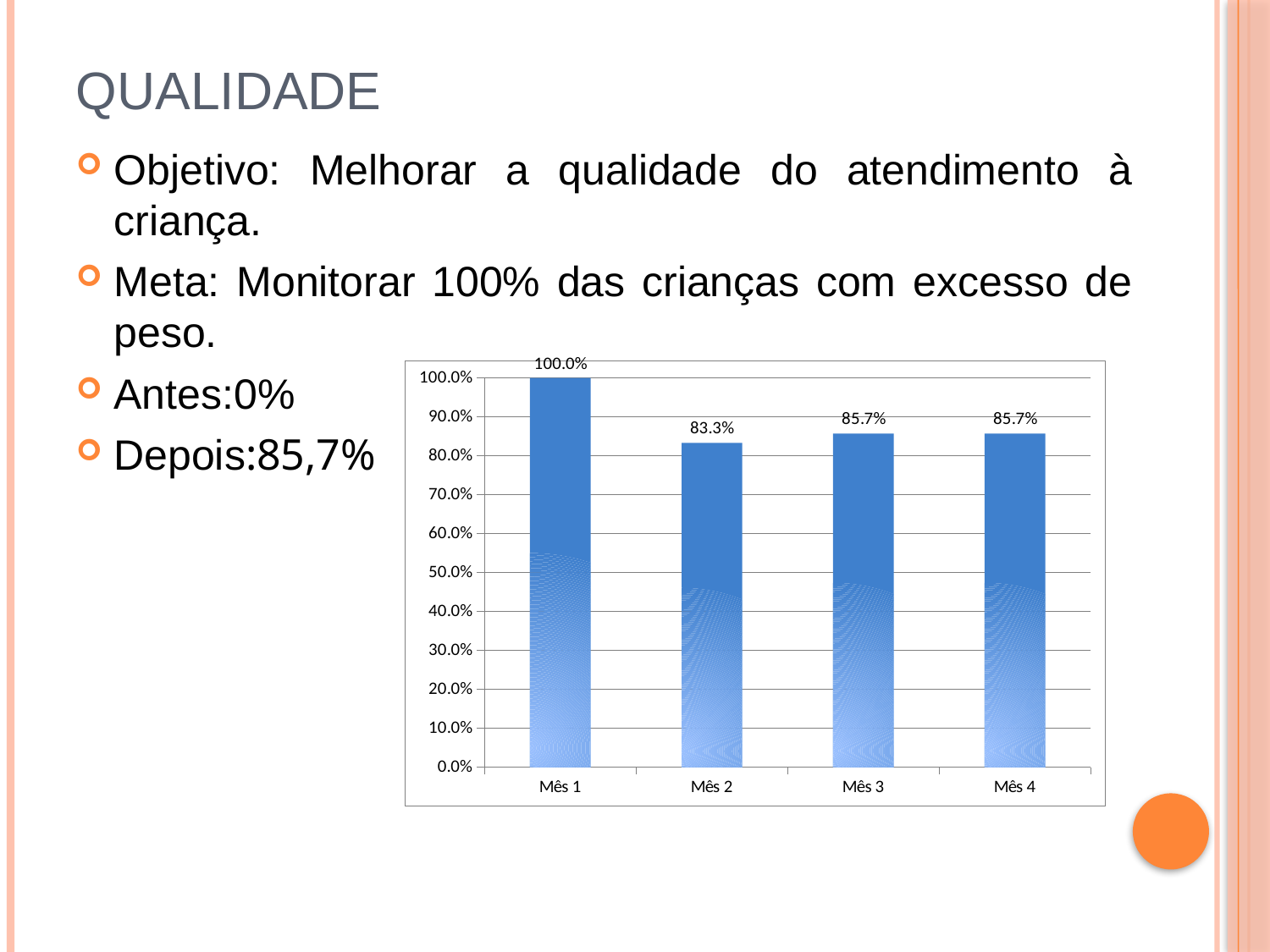
What is the value for Mês 4? 85.7% Which month has the highest value? Mês 1 What is the difference between the values for Mês 3 and Mês 2? 2.4% What is the value for Mês 2? 83.3% Is the value for Mês 2 greater or less than 90.0%? less What is the difference between the values for Mês 1 and Mês 2? 16.7% What is the value for Mês 1? 100.0% How many months are shown on the x axis? 4 Which is larger, the value for Mês 1 or the value for Mês 3? Mês 1 What is the value for Mês 3? 85.7% Which month has the lowest value? Mês 2 What kind of chart is shown on the slide? bar chart